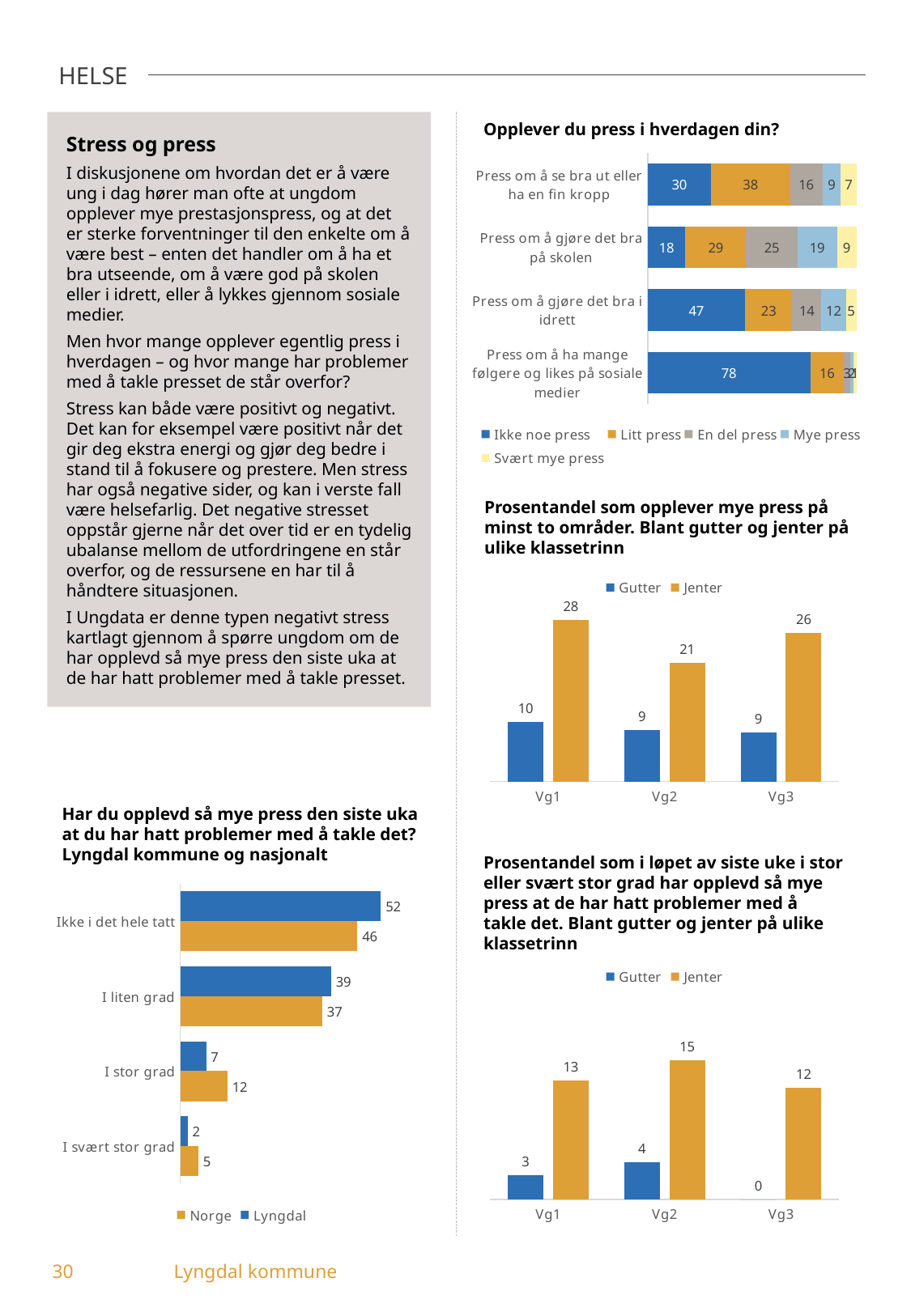
In the chart 'Prosentandel som opplever mye press på minst to områder', at which class level is the Jenter value lowest? Vg2 In the chart 'Opplever du press i hverdagen din?', what is the value for 'En del press' for 'Press om å gjøre det bra på skolen'? 25 In the chart 'Opplever du press i hverdagen din?', what percentage answered 'Ikke noe press' for 'Press om å ha mange følgere og likes på sosiale medier'? 78 In the chart 'Har du opplevd så mye press den siste uka at du har hatt problemer med å takle det?', what is the value for Lyngdal for 'Ikke i det hele tatt'? 52 What kind of chart is 'Har du opplevd så mye press den siste uka at du har hatt problemer med å takle det?'? Bar chart In the chart 'Opplever du press i hverdagen din?', which category has the highest 'Litt press' value? Press om å se bra ut eller ha en fin kropp How many series does the legend of the chart 'Opplever du press i hverdagen din?' list? 5 In the chart 'Prosentandel som opplever mye press på minst to områder', what is the difference between Jenter and Gutter at Vg3? 17 In the chart 'Prosentandel som opplever mye press på minst to områder', what is the value for Jenter at Vg1? 28 In the chart 'Prosentandel som i løpet av siste uke i stor eller svært stor grad har opplevd så mye press', what is the value for Gutter at Vg3? 0 In the chart 'Har du opplevd så mye press den siste uka at du har hatt problemer med å takle det?', which is larger for 'I stor grad': Norge or Lyngdal? Norge In the chart 'Prosentandel som i løpet av siste uke i stor eller svært stor grad har opplevd så mye press', at which class level is the Jenter value highest? Vg2